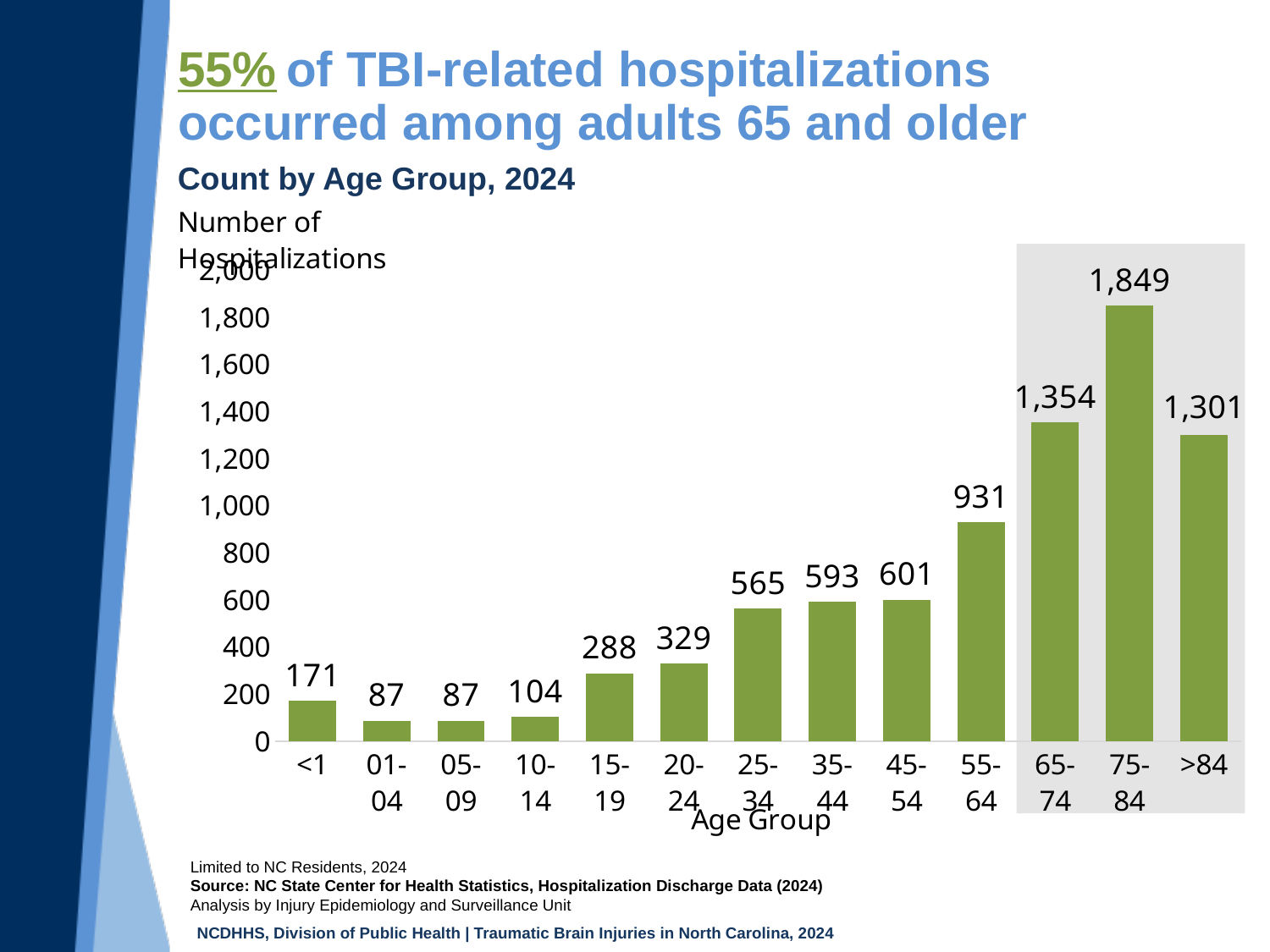
What is the number of hospitalizations for the <1 age group? 171 What is the lowest value shown on the chart? 87 Is the value for the 55-64 age group greater or less than 1,000? less What type of chart is shown on the slide? Bar chart What is the difference in hospitalizations between the 75-84 and 65-74 age groups? 495 Which age group has more hospitalizations, 65-74 or >84? 65-74 What is the label of the x axis? Age Group Which age group has the highest number of hospitalizations? 75-84 How many age groups are shown on the chart? 13 What is the number of hospitalizations for the 75-84 age group? 1,849 What is the difference in hospitalizations between the 45-54 and 35-44 age groups? 8 What is the number of hospitalizations for the 55-64 age group? 931